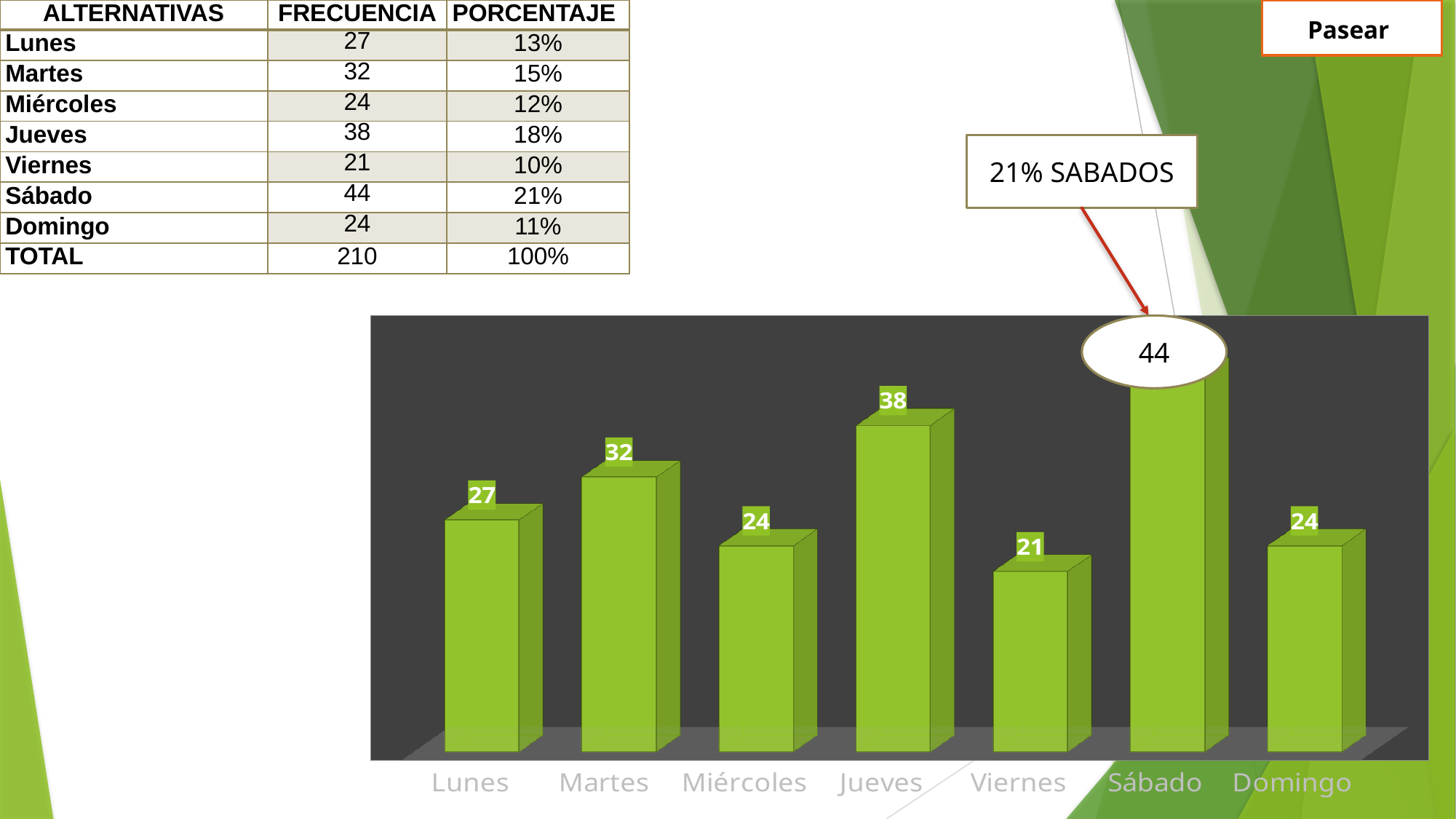
What is the total of all the values shown in the bar chart? 210 What is the difference between the values for Sábado and Viernes? 23 What is the difference between the values for Martes and Lunes? 5 What percentage does the callout box above the chart attribute to Sábados? 21% Which category has the highest value in the bar chart? Sábado What is the value for Sábado in the bar chart? 44 Which category has the lowest value in the bar chart? Viernes How many categories are shown on the x axis of the bar chart? 7 What is the value for Viernes in the bar chart? 21 What is the value for Jueves in the bar chart? 38 What kind of chart is shown on the slide? bar chart Which is larger, the value for Jueves or the value for Martes? Jueves